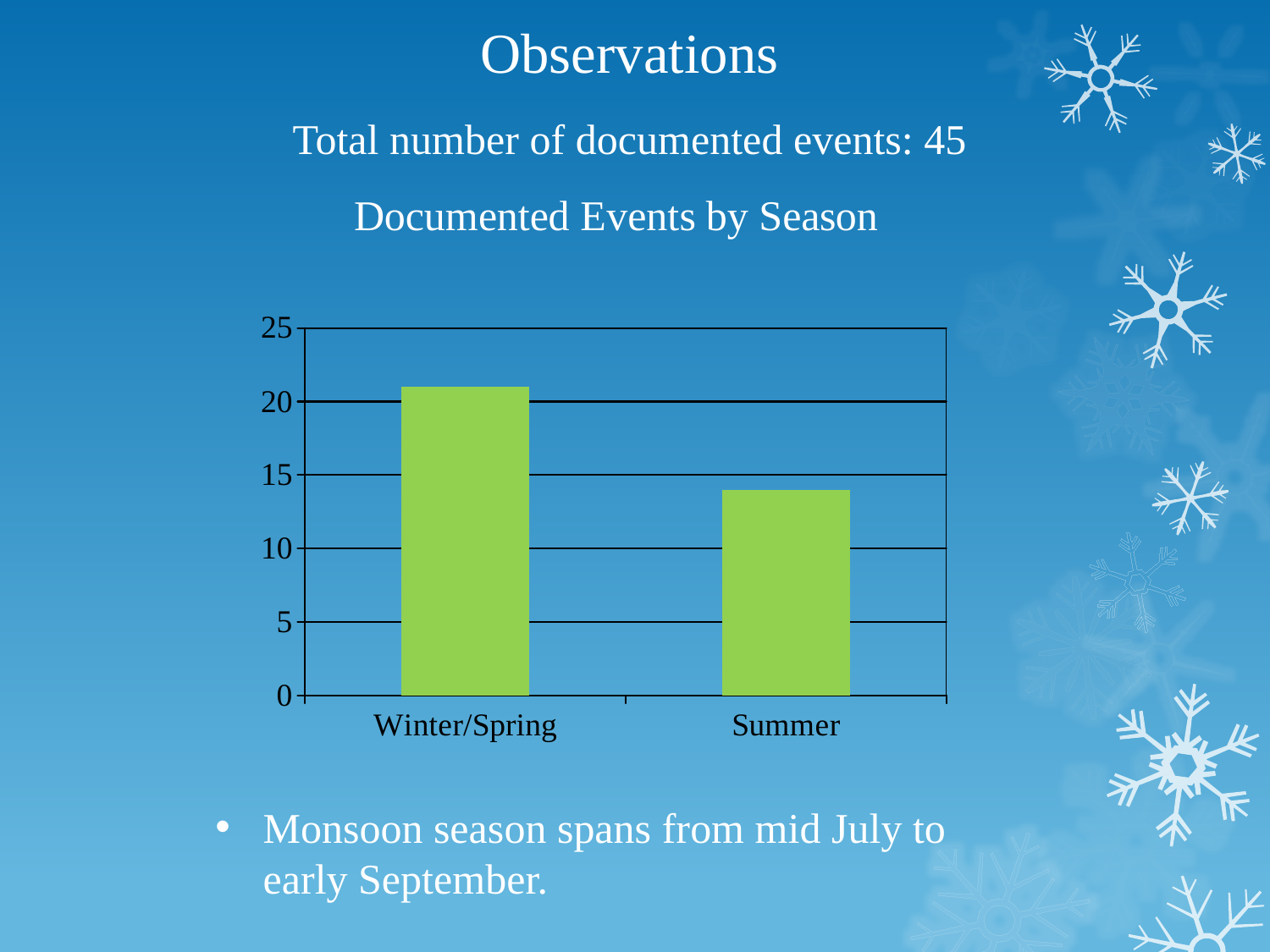
Is the value for Winter/Spring greater or less than 15? greater Which season has the highest number of documented events in the chart? Winter/Spring Which season has the lowest number of documented events in the chart? Summer Is the value for Summer greater or less than 20? less Is the value for Winter/Spring greater or less than 25? less How many categories are shown on the x axis of the chart? 2 What is the highest value shown on the chart's vertical axis? 25 What kind of chart is shown on the slide? bar chart Which is larger, the value for Winter/Spring or the value for Summer? Winter/Spring What is the title of the chart? Documented Events by Season